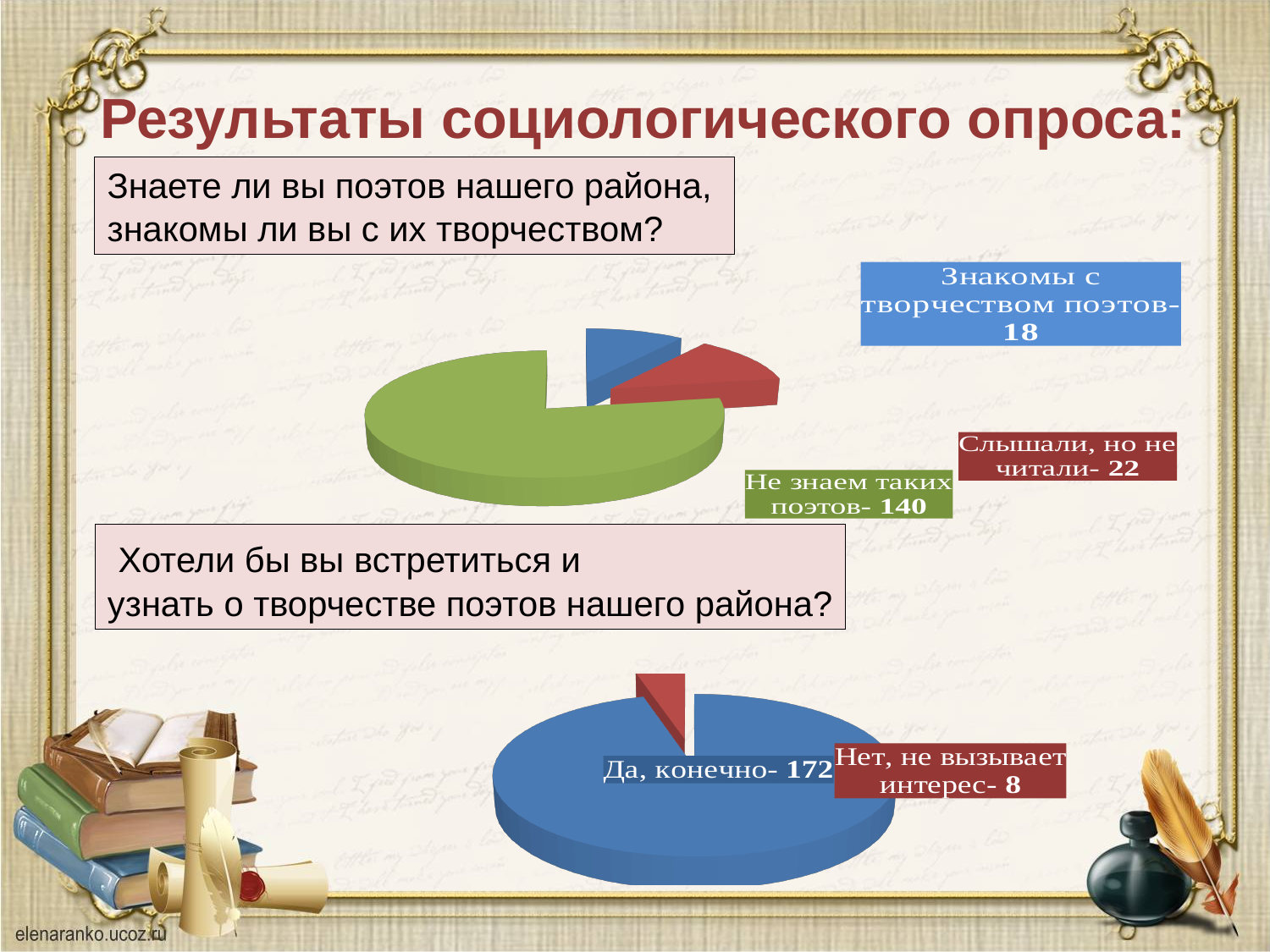
In the top pie chart, how many respondents answered "Не знаем таких поэтов"? 140 In the bottom pie chart, what is the value for "Нет, не вызывает интерес"? 8 In the top pie chart, which category has the largest value? Не знаем таких поэтов In the top pie chart, what is the value for "Знакомы с творчеством поэтов"? 18 What type of chart is the bottom chart on the slide? Pie chart In the bottom pie chart, how many respondents answered "Да, конечно"? 172 In the top pie chart, how many categories are shown? 3 In the top pie chart, what is the value for "Слышали, но не читали"? 22 In the top pie chart, what share of all responses does "Знакомы с творчеством поэтов" represent? 10% In the bottom pie chart, what is the difference between "Да, конечно" and "Нет, не вызывает интерес"? 164 In the top pie chart, what is the difference between "Не знаем таких поэтов" and "Слышали, но не читали"? 118 In the top pie chart, which category has the smallest value? Знакомы с творчеством поэтов